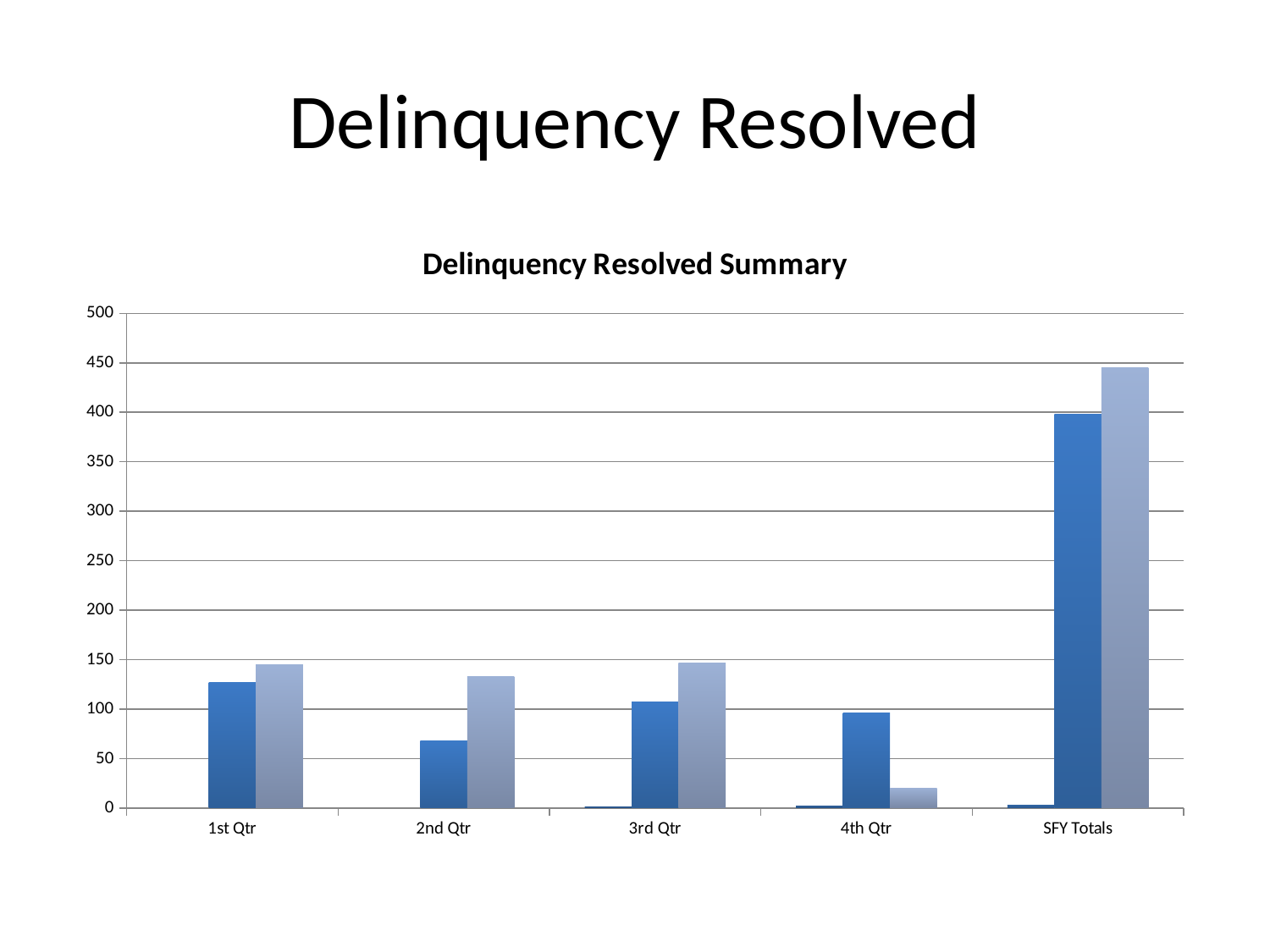
What kind of chart is shown on the slide? bar chart Is the value of the lighter blue bar for 4th Qtr greater or less than 50? less Is the value of the lighter blue bar for SFY Totals greater or less than 400? greater Is the value of the darker blue bar for 2nd Qtr greater or less than 50? greater For 2nd Qtr, which bar is larger, the darker blue bar or the lighter blue bar? the lighter blue bar What is the title of the chart? Delinquency Resolved Summary Among the four quarters, which quarter has the lowest lighter blue bar? 4th Qtr Which category has the tallest bars in the chart? SFY Totals How many categories are shown on the x axis of the chart? 5 For 4th Qtr, which bar is larger, the darker blue bar or the lighter blue bar? the darker blue bar